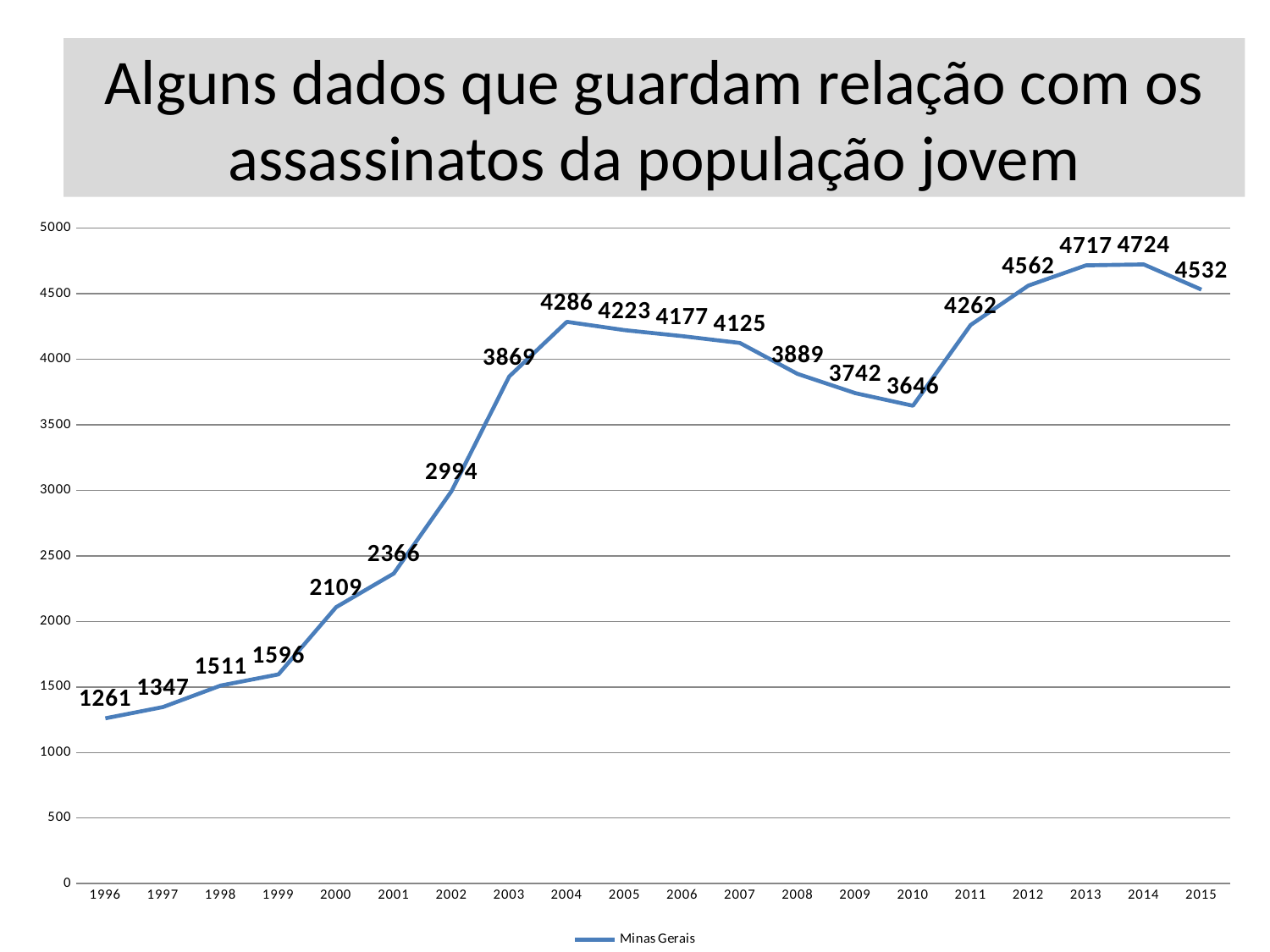
What is the difference between the values for 2015 and 2014? 192 How many years are plotted on the x axis? 20 What is the difference between the values for 2003 and 2002? 875 In which year is the value for Minas Gerais lowest? 1996 In which year is the value for Minas Gerais highest? 2014 What is the value for Minas Gerais in 1996? 1261 What is the value for Minas Gerais in 2010? 3646 What is the value for Minas Gerais in 2004? 4286 What type of chart is shown on the slide? line chart Which year has the larger value, 2008 or 2011? 2011 How many series does the legend list? 1 What is the name of the series shown in the legend? Minas Gerais